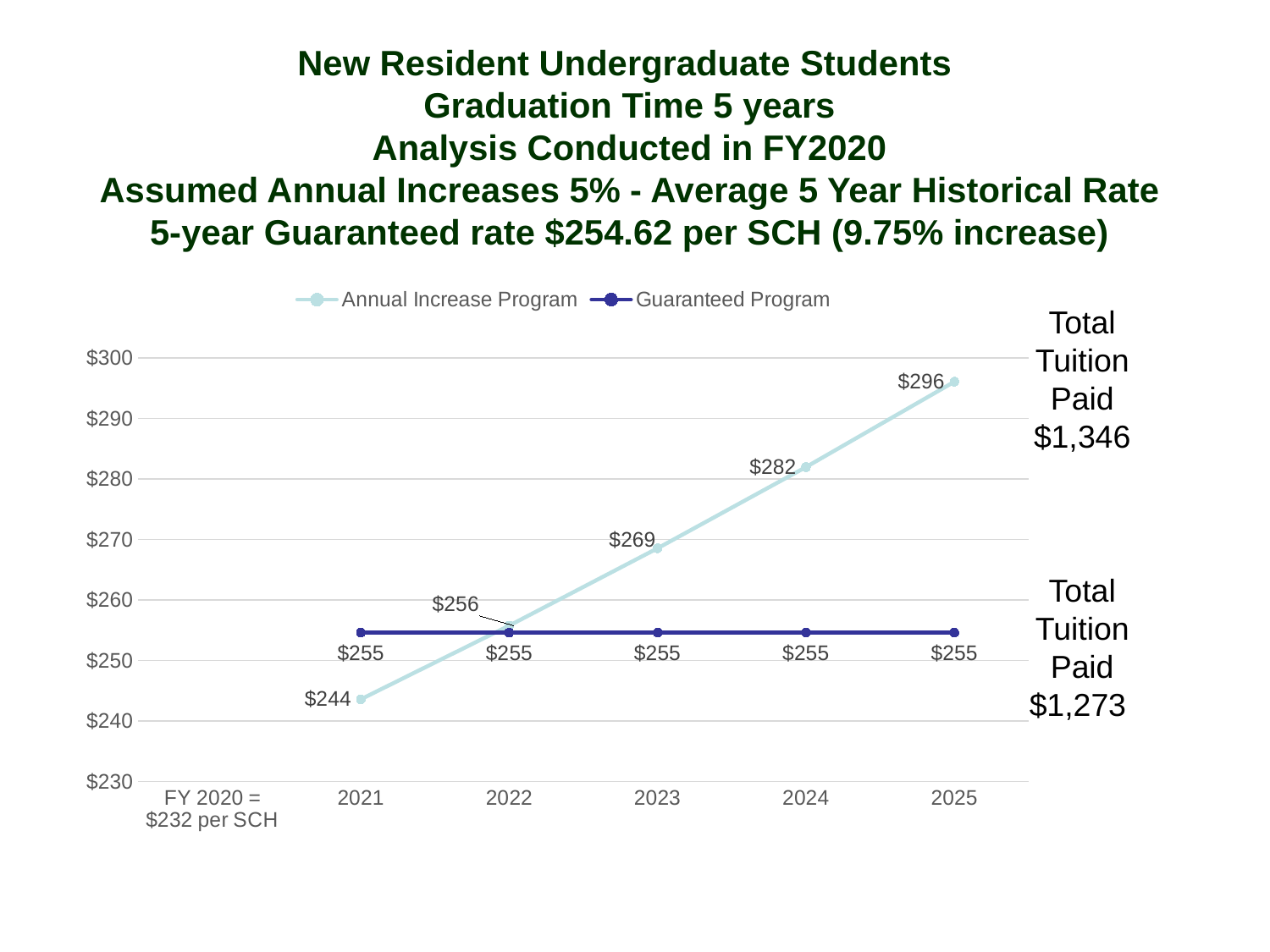
What is the difference between the Annual Increase Program value in 2025 and in 2021? $52 What is the value for the Annual Increase Program in 2021? $244 How many series does the legend list? 2 Which is larger in 2024, the Annual Increase Program value or the Guaranteed Program value? Annual Increase Program What type of chart is shown on the slide? line chart In which year is the Annual Increase Program value lowest? 2021 What is the value for the Guaranteed Program in 2023? $255 Does the Annual Increase Program value rise or fall from 2021 to 2025? rise What is the value for the Annual Increase Program in 2023? $269 In which year is the Annual Increase Program value highest? 2025 What is the value for the Annual Increase Program in 2025? $296